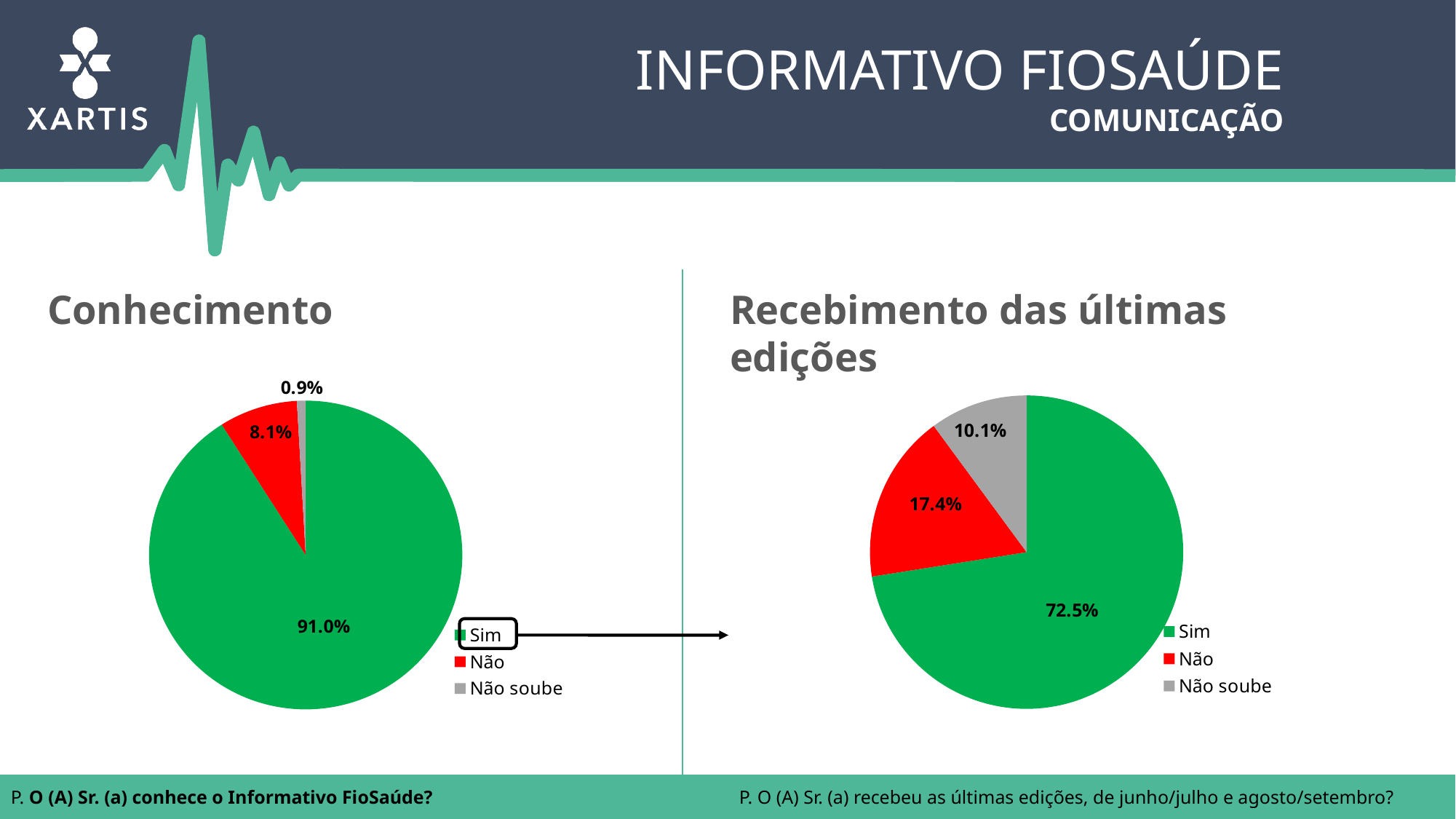
Which chart has the larger 'Não' share, 'Conhecimento' or 'Recebimento das últimas edições'? Recebimento das últimas edições In the 'Conhecimento' pie chart, which category has the smallest slice? Não soube In the 'Recebimento das últimas edições' pie chart, what share is labelled for 'Não'? 17.4% In the 'Recebimento das últimas edições' pie chart, what share is labelled for 'Sim'? 72.5% In the 'Recebimento das últimas edições' pie chart, what is the difference between the 'Não' and 'Não soube' shares? 7.3% How many categories does the legend of the 'Recebimento das últimas edições' chart list? 3 In the 'Recebimento das últimas edições' pie chart, what share is labelled for 'Não soube'? 10.1% In the 'Conhecimento' pie chart, what share is labelled for 'Não soube'? 0.9% What type of chart is used on the left side of the slide under 'Conhecimento'? Pie chart In the 'Conhecimento' pie chart, what share is labelled for 'Sim'? 91.0% In the 'Recebimento das últimas edições' pie chart, which category has the largest slice? Sim In the 'Conhecimento' pie chart, what share is labelled for 'Não'? 8.1%